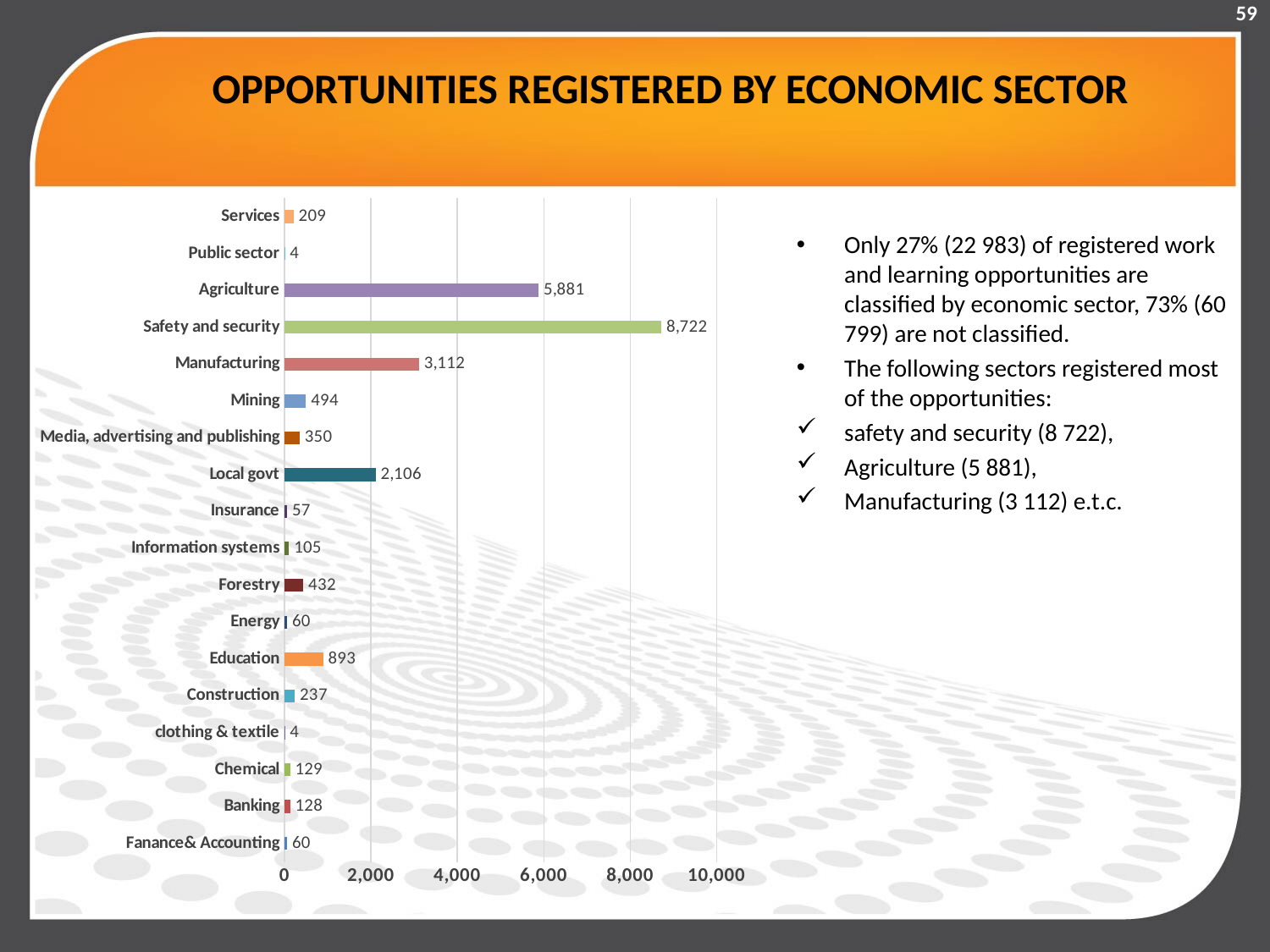
What value is shown for Safety and security? 8,722 What kind of chart is shown on the slide? Bar chart Which is larger, the value for Mining or the value for Forestry? Mining What value is shown for Media, advertising and publishing? 350 Which sector has the highest number of registered opportunities? Safety and security How many sectors are shown in the chart? 18 What value is shown for Local govt? 2,106 What value is shown for Education? 893 Is the value for Manufacturing greater or less than 2,000? greater What is the difference between the values for Local govt and Education? 1,213 What is the title of the slide containing the chart? OPPORTUNITIES REGISTERED BY ECONOMIC SECTOR What is the difference between the values for Safety and security and Agriculture? 2,841